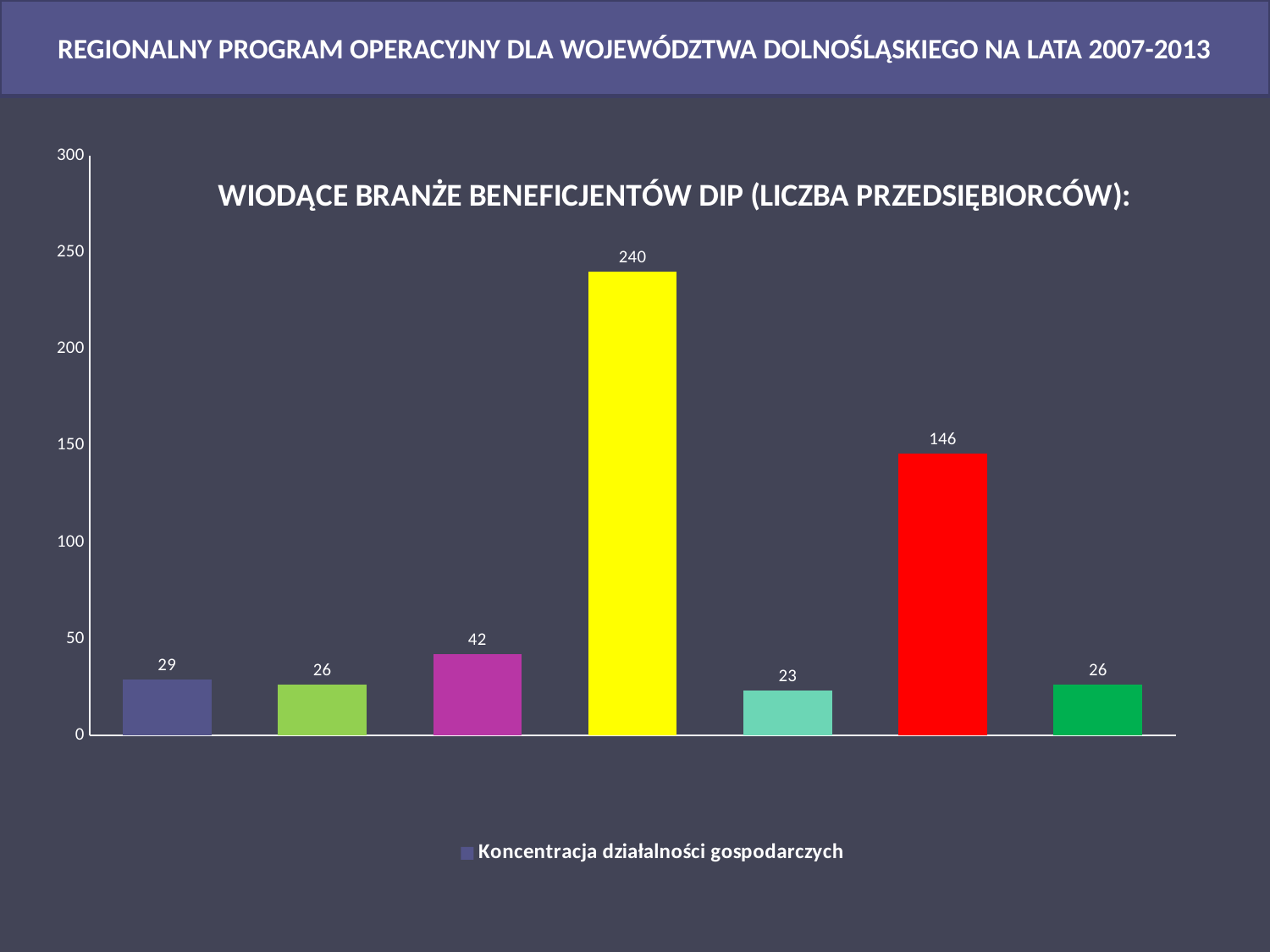
What is the value shown on the red bar? 146 What is the value shown on the magenta (purple-pink) bar? 42 Which bar has the highest value? The yellow bar (240) Is the value of the red bar greater or less than 100? greater What is the value shown on the yellow bar? 240 Which is larger, the value of the magenta bar or the value of the first (blue) bar? The magenta bar (42) How many bars are plotted in the chart? 7 What is the legend entry shown below the chart? Koncentracja działalności gospodarczych What type of chart is shown on the slide? Bar chart What is the value shown on the first bar from the left? 29 What is the difference between the yellow bar's value and the red bar's value? 94 Which bar has the lowest value? The teal bar (23)